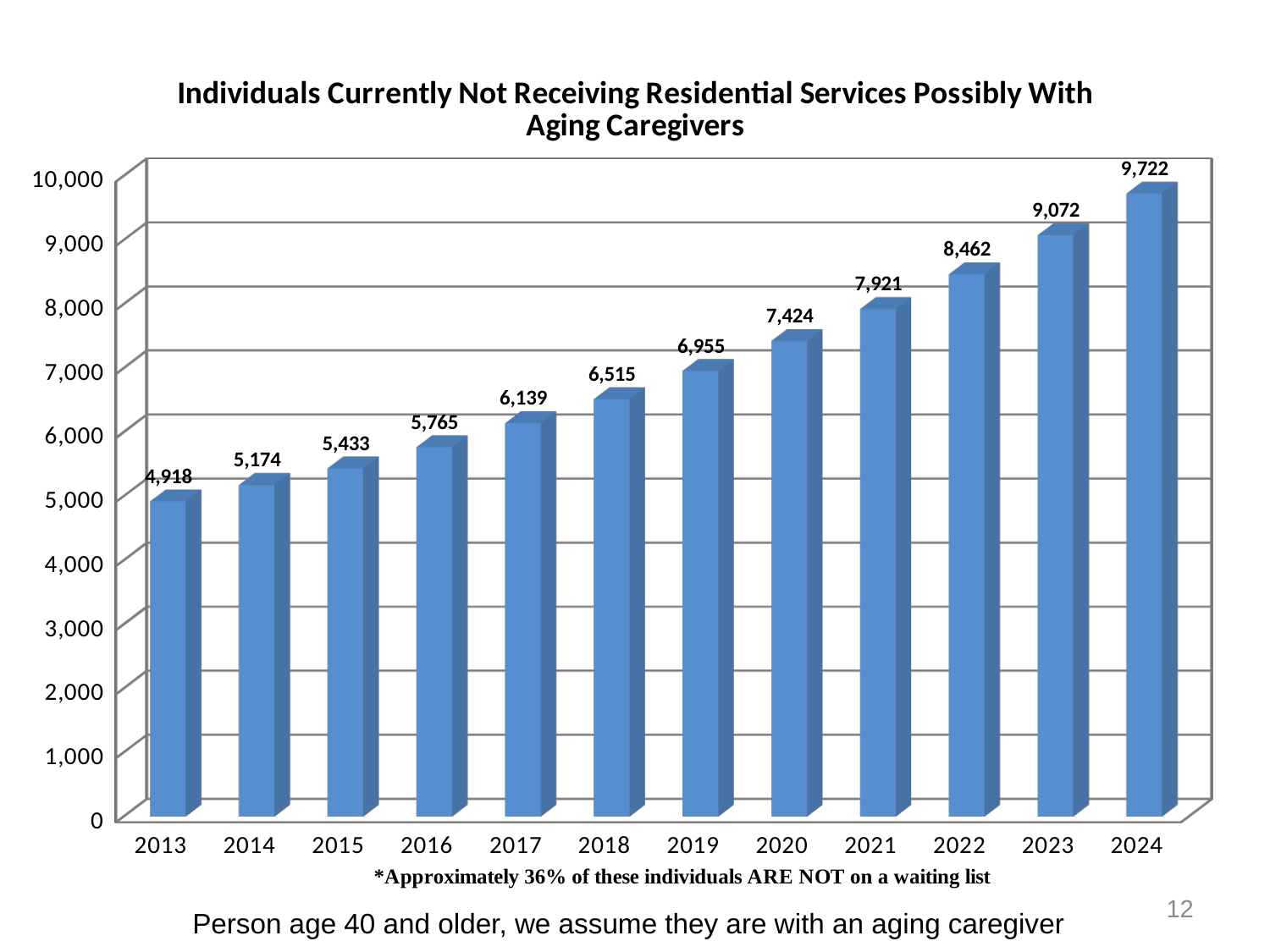
What is the value for 2013? 4,918 Do the values rise or fall from 2013 to 2024? rise Which year has the highest value? 2024 What is the difference between the values for 2024 and 2013? 4,804 What is the difference between the values for 2021 and 2020? 497 Which year has the lowest value? 2013 What is the value for 2019? 6,955 What is the value for 2024? 9,722 How many years are shown on the x axis? 12 What kind of chart is shown on the slide? bar chart Is the value for 2018 greater or less than 6,000? greater Which is larger, the value for 2017 or the value for 2022? 2022